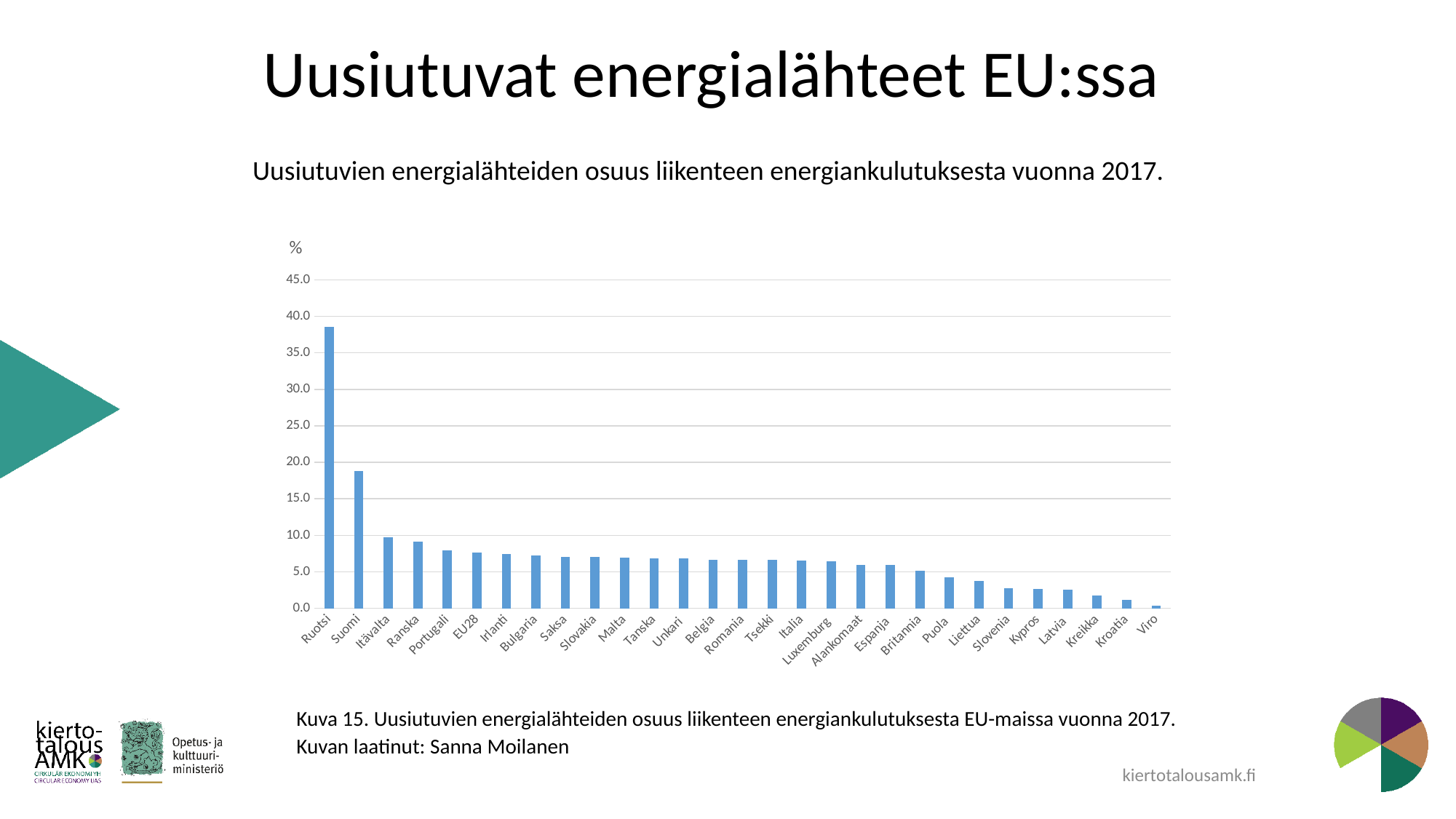
Which has a larger value, Itävalta or Puola? Itävalta What kind of chart is shown on the slide? bar chart Is the value for EU28 greater or less than 10.0? less Which has a larger value, Ruotsi or Suomi? Ruotsi Is the value for Ruotsi greater or less than 35.0? greater Is the value for Suomi greater or less than 20.0? less Do the values rise or fall moving from left to right along the x axis? fall How many categories (bars) are shown in the chart? 29 What unit is shown on the y axis of the chart? % Which category has the lowest value in the chart? Viro Which country has the highest share of renewable energy in transport energy consumption? Ruotsi